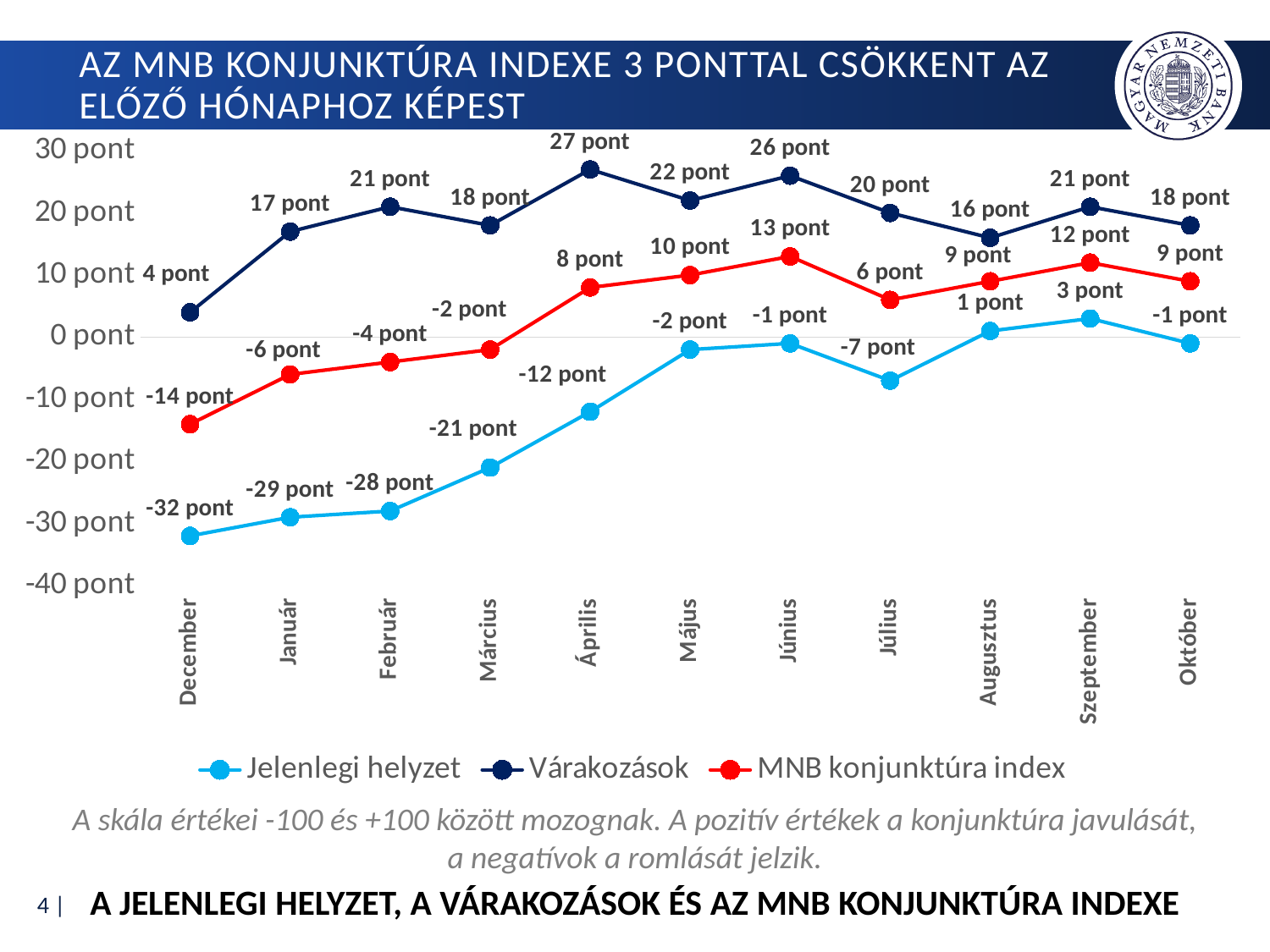
Which is larger in Június: the Várakozások value or the MNB konjunktúra index value? Várakozások How many series does the legend list? 3 Which series is drawn in red? MNB konjunktúra index In which month is the Várakozások series at its highest? Április What is the difference between the MNB konjunktúra index in Szeptember and in Október? 3 pont How many months are plotted along the x axis? 11 In which month is the Jelenlegi helyzet series at its lowest? December Does the Jelenlegi helyzet series generally rise or fall from December to Október? rise What is the value of the MNB konjunktúra index in Október? 9 pont What is the value of Jelenlegi helyzet in December? -32 pont What is the value of Várakozások in Április? 27 pont What type of chart is shown on the slide? line chart